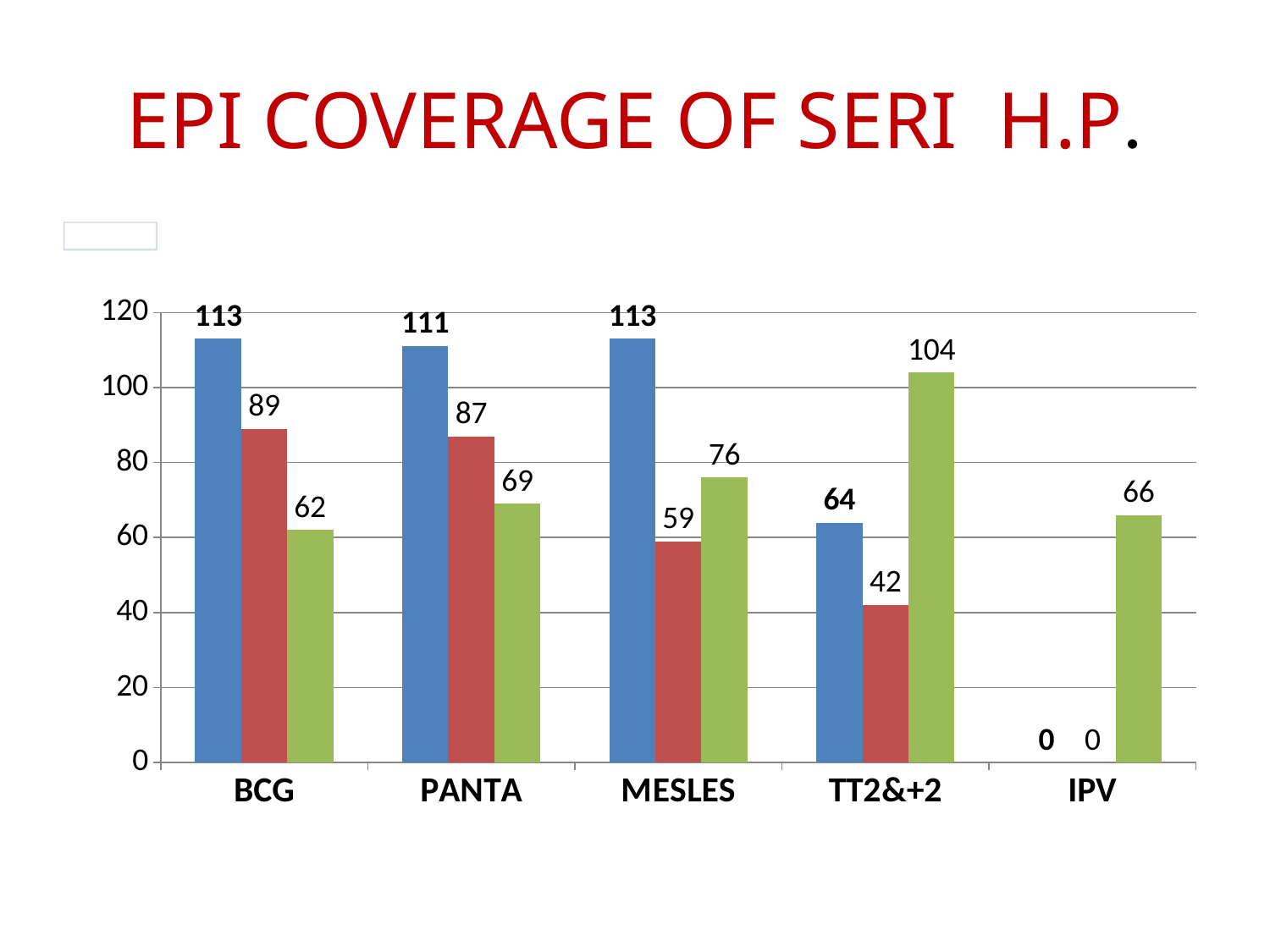
What is the title of the slide? EPI COVERAGE OF SERI H.P. Which category has the highest green bar? TT2&+2 What is the value of the red bar for MESLES? 59 What is the difference between the green bar for TT2&+2 and the green bar for BCG? 42 What is the value of the blue bar for BCG? 113 How many categories are shown on the x axis? 5 What is the value of the green bar for TT2&+2? 104 What kind of chart is shown on the slide? bar chart What is the difference between the blue bar and the red bar for PANTA? 24 What is the value of the green bar for IPV? 66 Which is larger for MESLES, the red bar or the green bar? the green bar Which category has the lowest blue bar? IPV